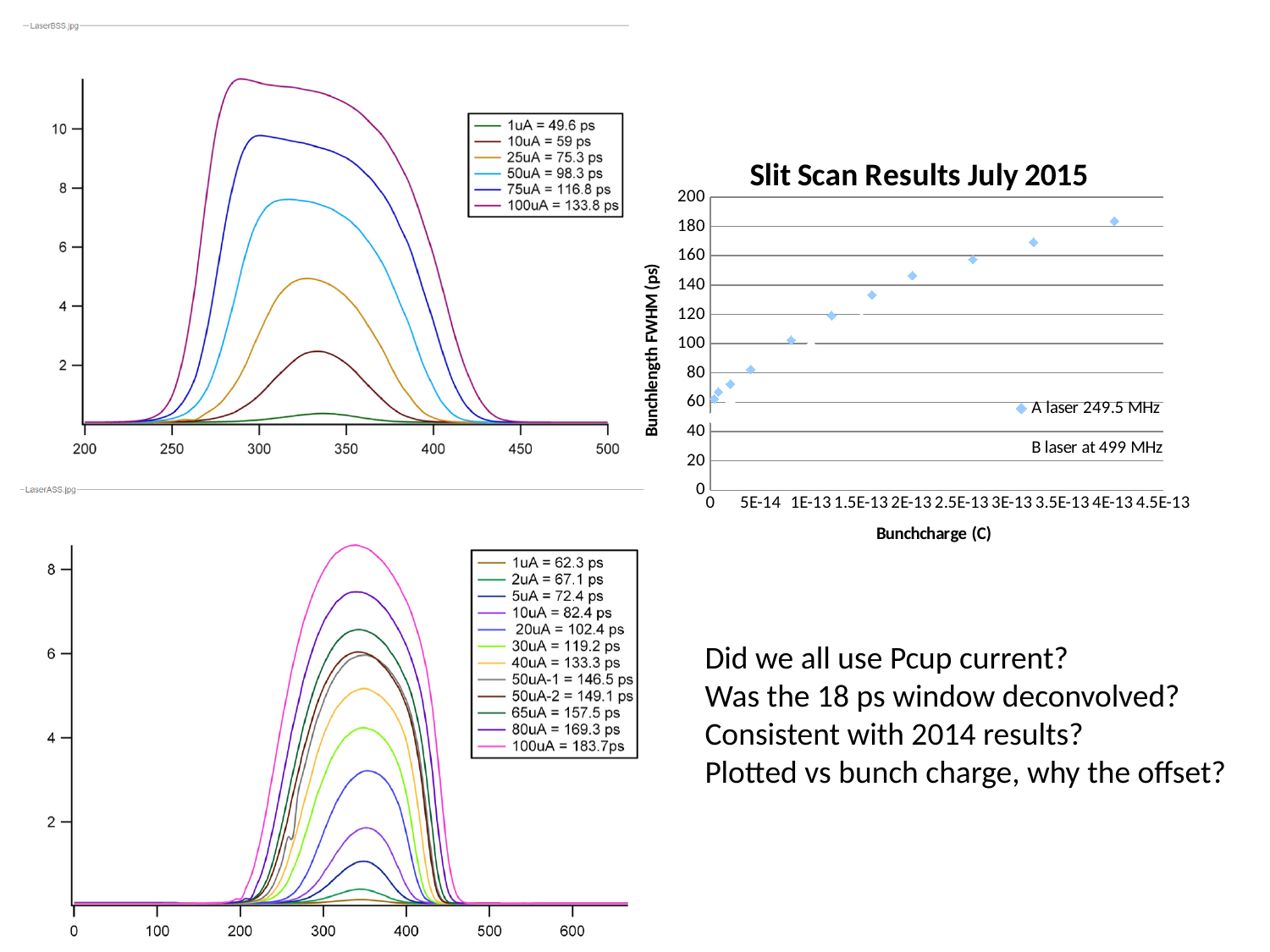
In the top-left chart (LaserBSS), what bunch length does the legend give for 100uA? 133.8 ps In the 'Slit Scan Results July 2015' chart, do the bunch length values rise or fall as bunch charge increases? rise In the 'Slit Scan Results July 2015' chart, how many series does the legend list? 2 In the bottom-left chart (LaserASS), what bunch length does the legend give for 40uA? 133.3 ps In the top-left chart (LaserBSS), what is the difference between the bunch lengths listed for 100uA and 1uA? 84.2 ps In the bottom-left chart (LaserASS), how many series does the legend list? 12 In the top-left chart (LaserBSS), which current has the smallest bunch length in the legend? 1uA In the top-left chart (LaserBSS), how many series does the legend list? 6 What kind of chart is the 'Slit Scan Results July 2015' chart? scatter chart In the 'Slit Scan Results July 2015' chart, is the value of the lowest point (near 0 C) greater or less than 80? less In the 'Slit Scan Results July 2015' chart, is the value of the highest point (near 4E-13 C) greater or less than 160? greater What is the title of the scatter chart on the right side of the slide? Slit Scan Results July 2015